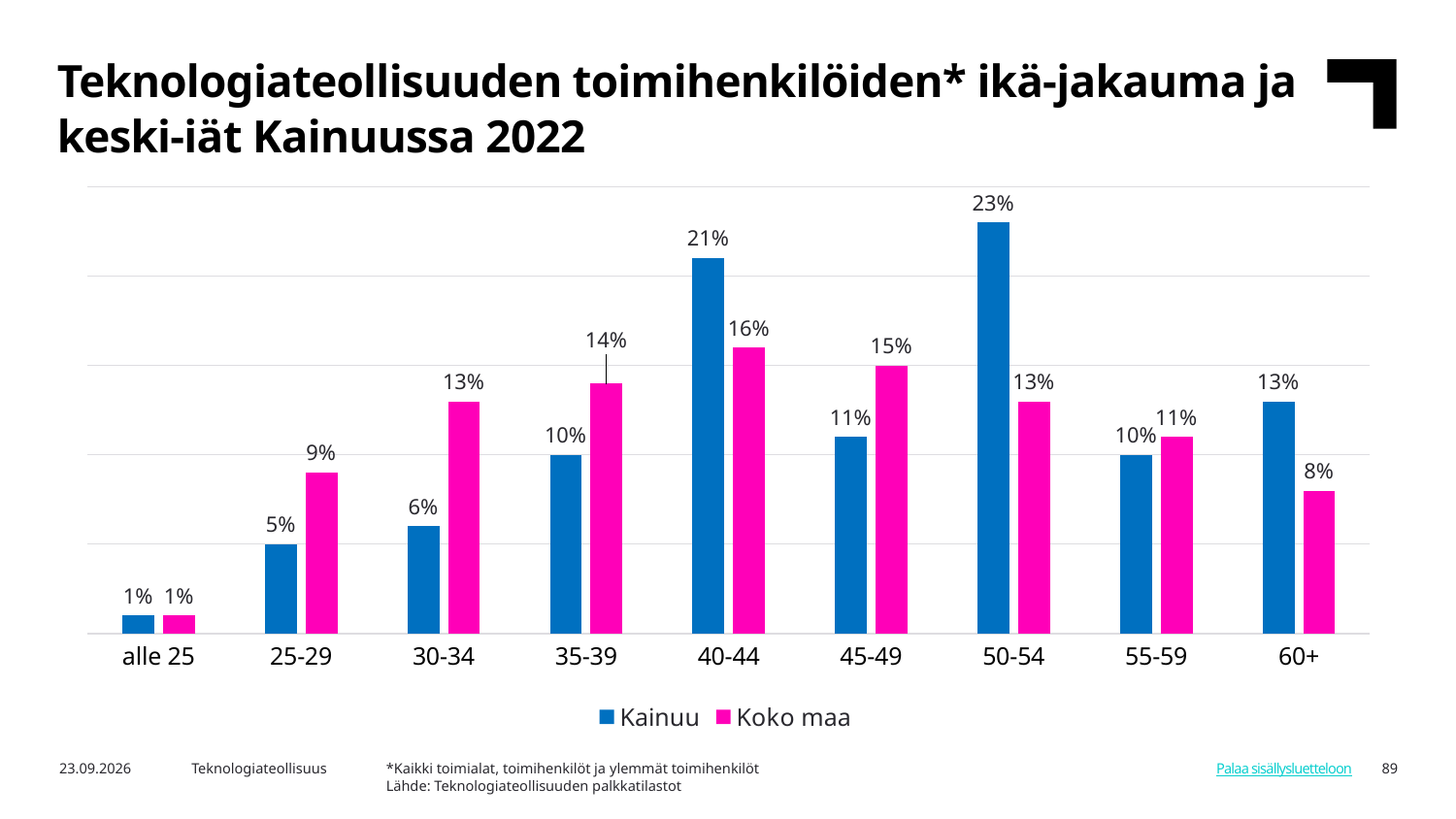
In the 45-49 age group, which series has the larger value, Kainuu or Koko maa? Koko maa In the 60+ age group, which series has the larger value, Kainuu or Koko maa? Kainuu How many age groups are shown on the x axis? 9 What is the difference between Kainuu and Koko maa in the 30-34 age group? 7 percentage points What is the value for Kainuu in the 50-54 age group? 23% What kind of chart is shown on the slide? Bar chart What is the value for Kainuu in the 35-39 age group? 10% Which series is shown in pink? Koko maa Which age group has the lowest value for Koko maa? alle 25 Which age group has the highest value for Kainuu? 50-54 How many series does the legend list? 2 What is the value for Koko maa in the 40-44 age group? 16%